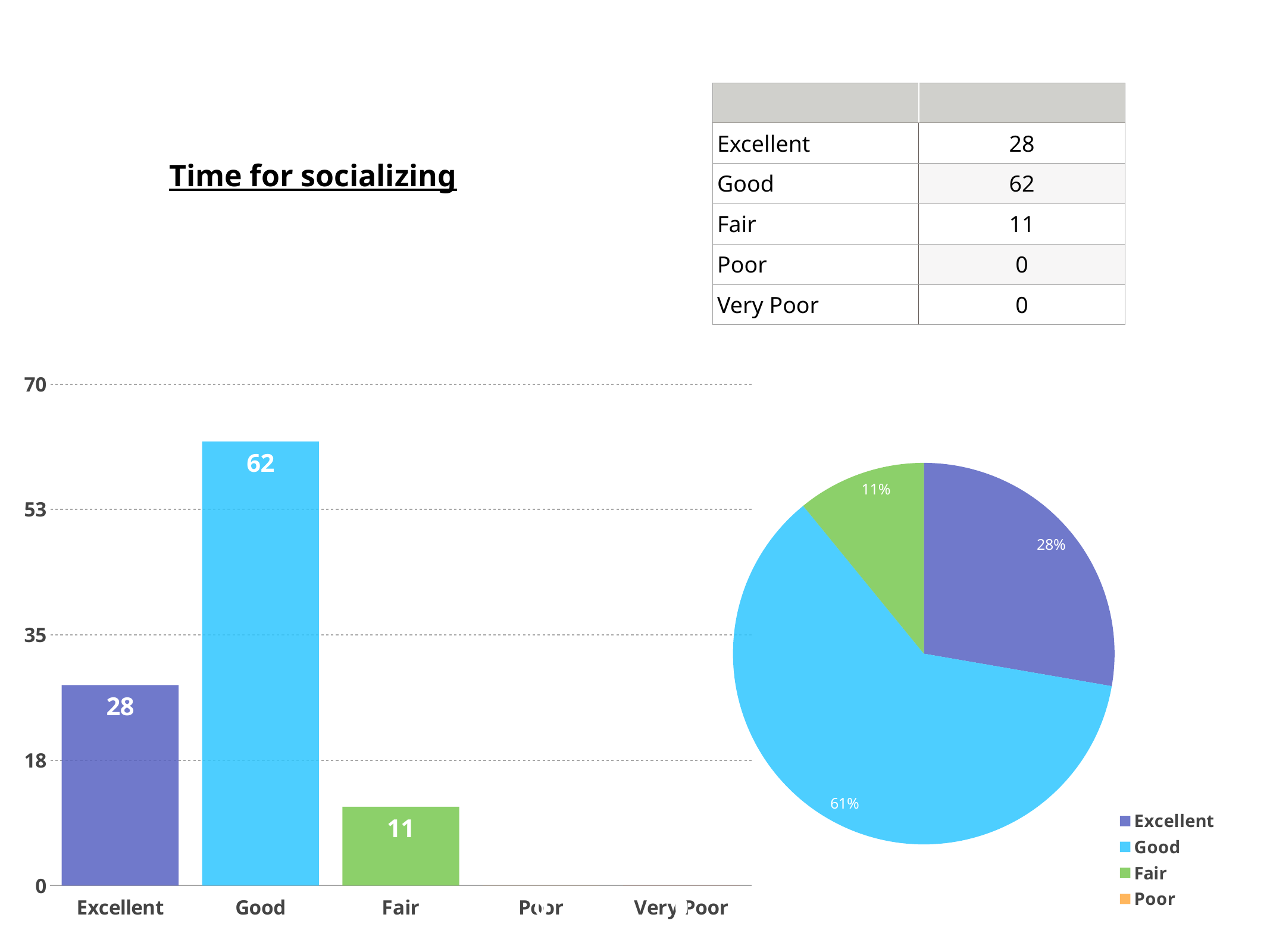
In the bar chart, what is the value for Excellent? 28 In the bar chart, what is the value for Good? 62 How many categories are shown on the x axis of the bar chart? 5 In the pie chart, what share does the Good slice have? 61% In the bar chart, what is the value for Fair? 11 In the bar chart, which category has the highest value? Good In the bar chart, what is the difference between the values for Good and Excellent? 34 In the pie chart, what share does the Fair slice have? 11% What kind of chart is the chart on the left of the slide? bar chart In the bar chart, which is larger, the value for Excellent or the value for Fair? Excellent How many entries does the legend of the pie chart list? 4 In the bar chart, is the value for Good greater or less than 53? greater